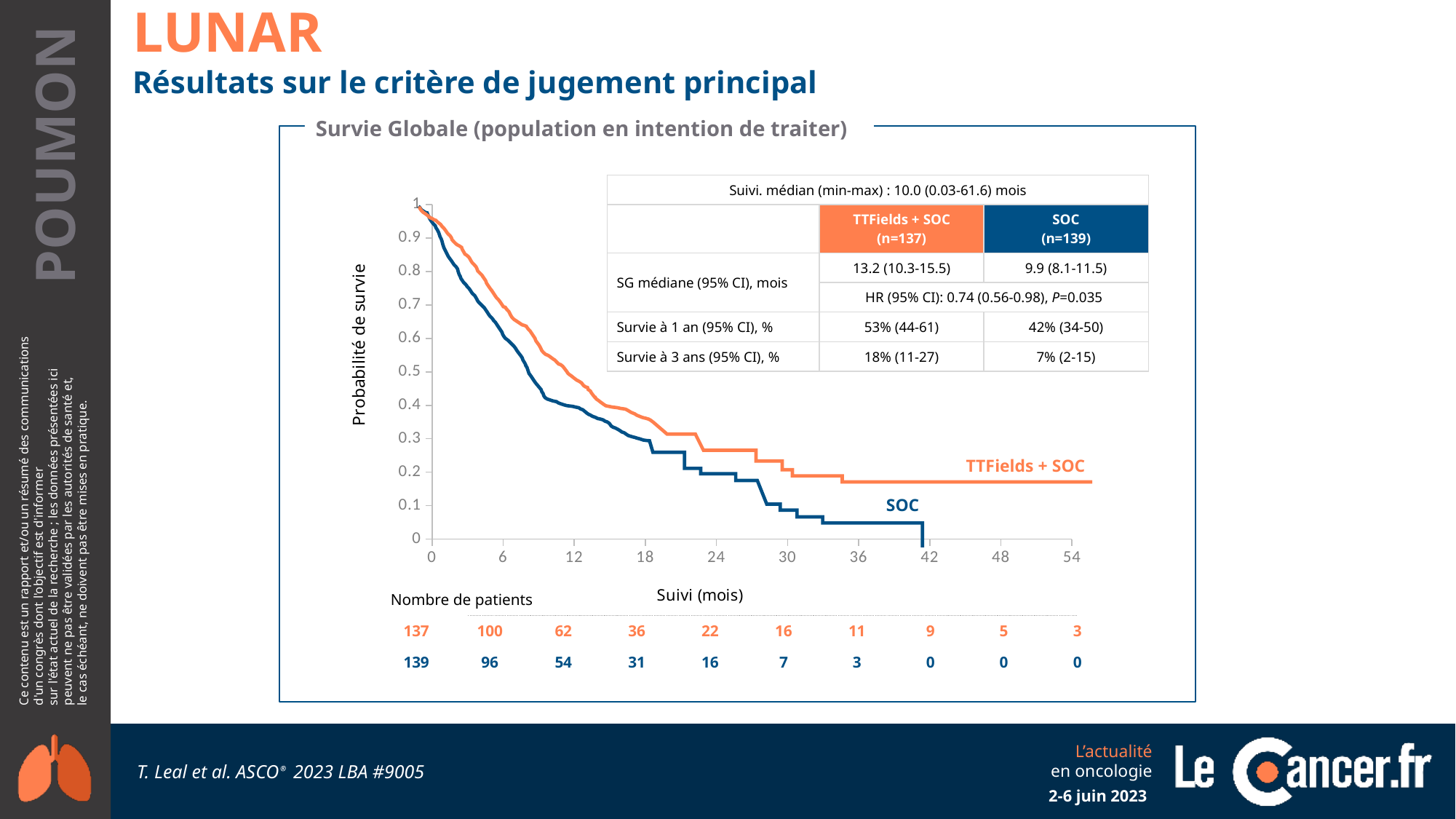
How many series (treatment arms) are plotted on the survival chart? 2 Do the survival curves rise or fall as follow-up time (months) increases? fall What is the hazard ratio reported for overall survival? HR (95% CI): 0.74 (0.56-0.98), P=0.035 What kind of chart is shown on the slide? Line chart (Kaplan-Meier survival curve) Which arm has the higher 3-year survival rate, TTFields + SOC or SOC? TTFields + SOC What is the 1-year survival rate for the SOC arm? 42% (34-50) What is the median overall survival (SG médiane) for the SOC arm? 9.9 (8.1-11.5) Is the survival probability for TTFields + SOC at 24 months greater or less than 0.2? greater What is the median overall survival (SG médiane) for the TTFields + SOC arm? 13.2 (10.3-15.5) What is the difference in 1-year survival rate between TTFields + SOC (53%) and SOC (42%)? 11% What is the 3-year survival rate for the TTFields + SOC arm? 18% (11-27) How many patients were at risk in the SOC arm at 12 months? 54